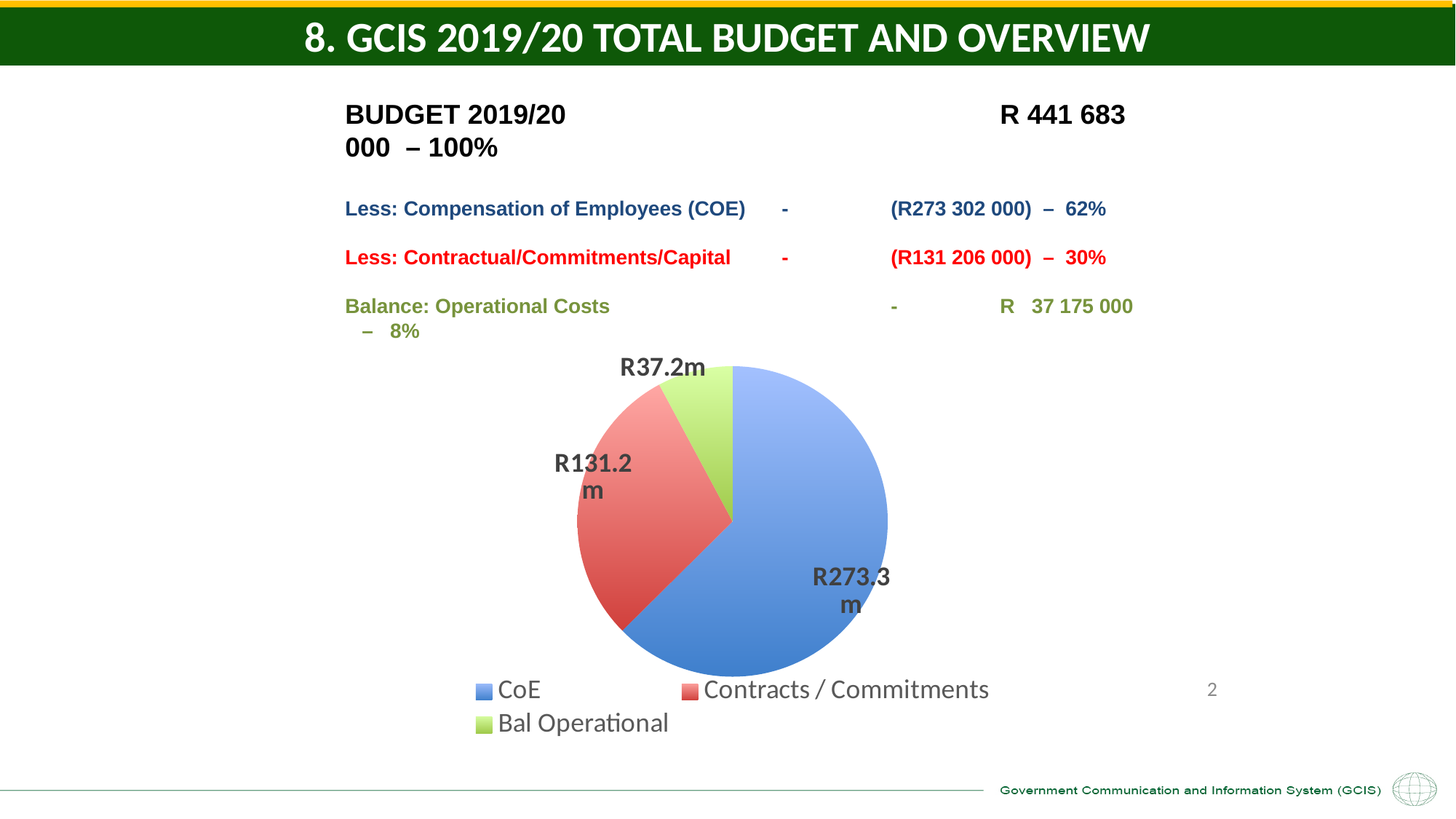
Which category has the smallest slice in the pie chart? Bal Operational Which category has the largest slice in the pie chart? CoE Which is larger in the pie chart, Contracts / Commitments or Bal Operational? Contracts / Commitments What is the value of the CoE slice in the pie chart? R273.3m What is the difference between the CoE slice and the Contracts / Commitments slice? R142.1m What type of chart is shown on the slide? pie chart What colour is the CoE slice in the pie chart? blue What is the value of the Contracts / Commitments slice in the pie chart? R131.2m How many slices does the pie chart have? 3 What colour is the Bal Operational slice in the pie chart? green What is the value of the Bal Operational slice in the pie chart? R37.2m How many entries does the legend of the pie chart list? 3